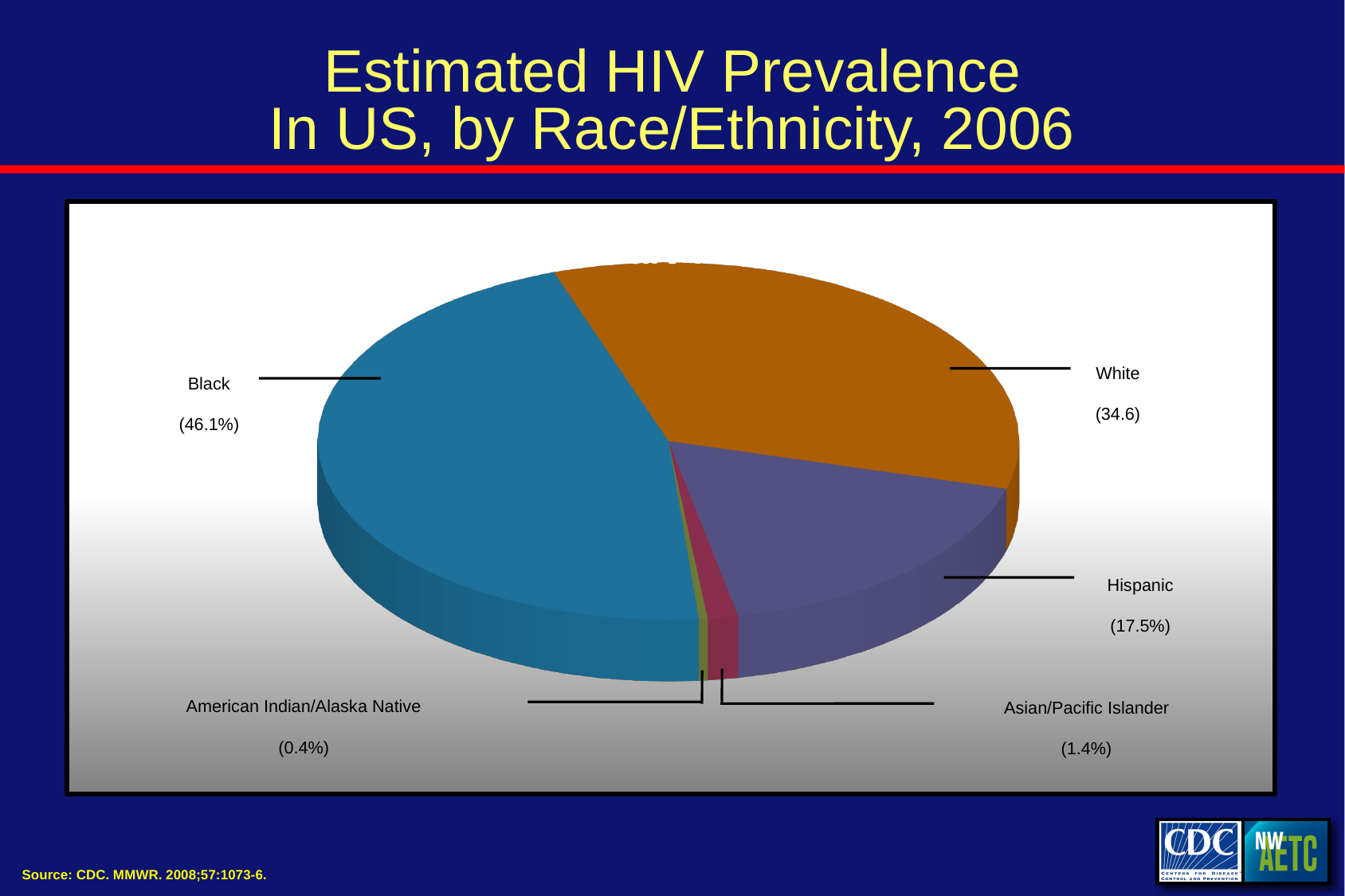
What is the title of the chart on the slide? Estimated HIV Prevalence In US, by Race/Ethnicity, 2006 What is the value shown for Hispanic? 17.5% What is the value shown for Asian/Pacific Islander? 1.4% Which race/ethnicity group has the largest share of the pie? Black Which is larger, the share for Hispanic or the share for Asian/Pacific Islander? Hispanic What is the value shown for Black? 46.1% What is the value shown for White? 34.6 What kind of chart is shown on the slide? Pie chart What is the value shown for American Indian/Alaska Native? 0.4% Which race/ethnicity group has the smallest share of the pie? American Indian/Alaska Native How many race/ethnicity categories are shown in the pie chart? 5 What is the difference in percentage points between the Black share (46.1%) and the Hispanic share (17.5%)? 28.6